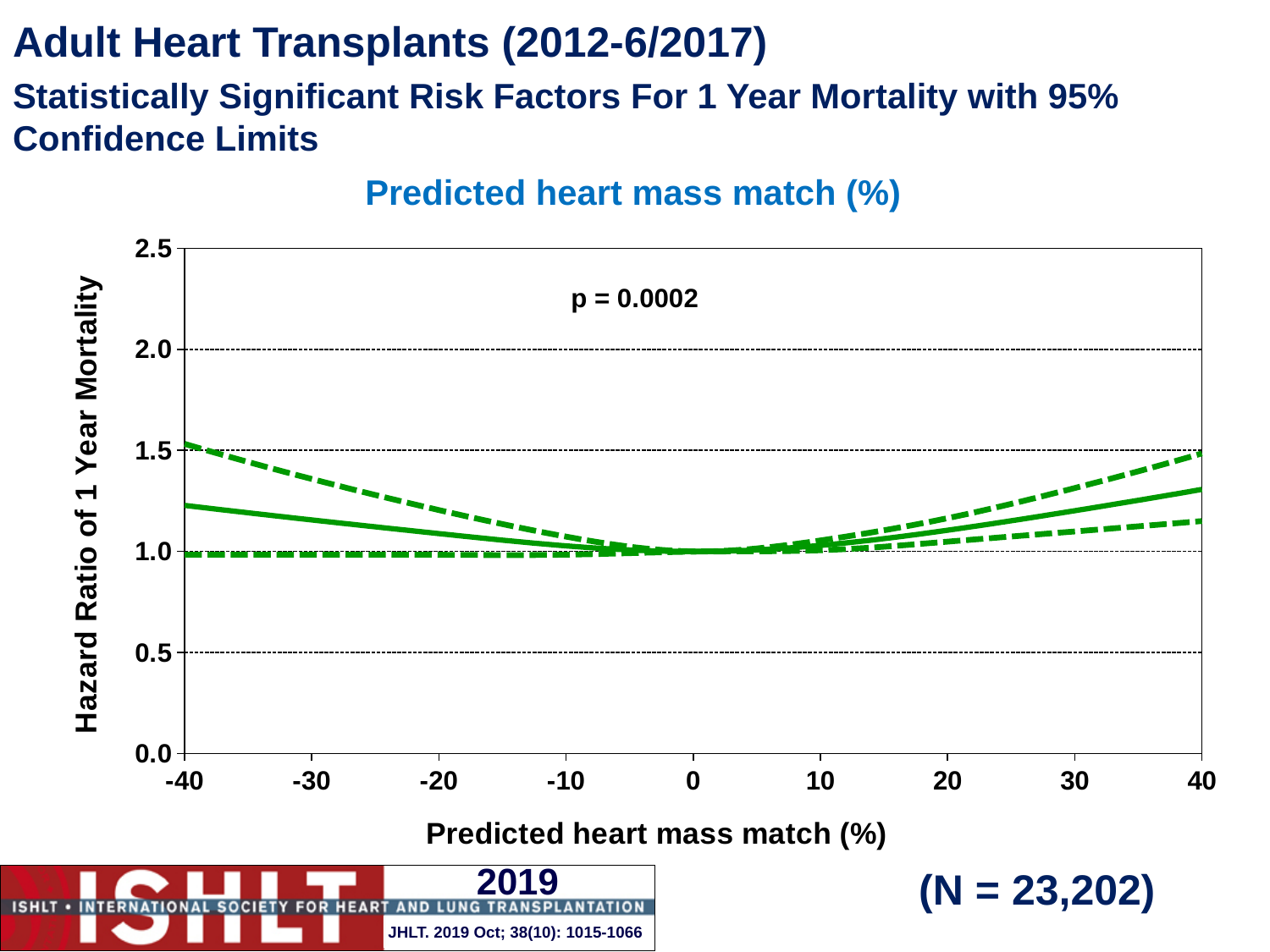
How many lines are plotted on the chart? 3 Is the hazard ratio of the solid line at a predicted heart mass match of 40% greater or less than 1.0? greater What is the highest value shown on the y axis of the chart? 2.5 Does the solid hazard ratio line rise or fall as predicted heart mass match goes from 0% to 40%? rise What is the p-value printed on the chart? p = 0.0002 Is the hazard ratio of the solid line at a predicted heart mass match of -40% greater or less than 1.0? greater How many tick labels are shown on the x axis of the chart? 9 Is the hazard ratio of the solid line at a predicted heart mass match of -40% greater or less than 1.5? less What kind of chart is shown on the slide? line chart What is the sample size (N) shown on the slide? 23,202 Does the solid hazard ratio line rise or fall as predicted heart mass match goes from -40% to 0%? fall